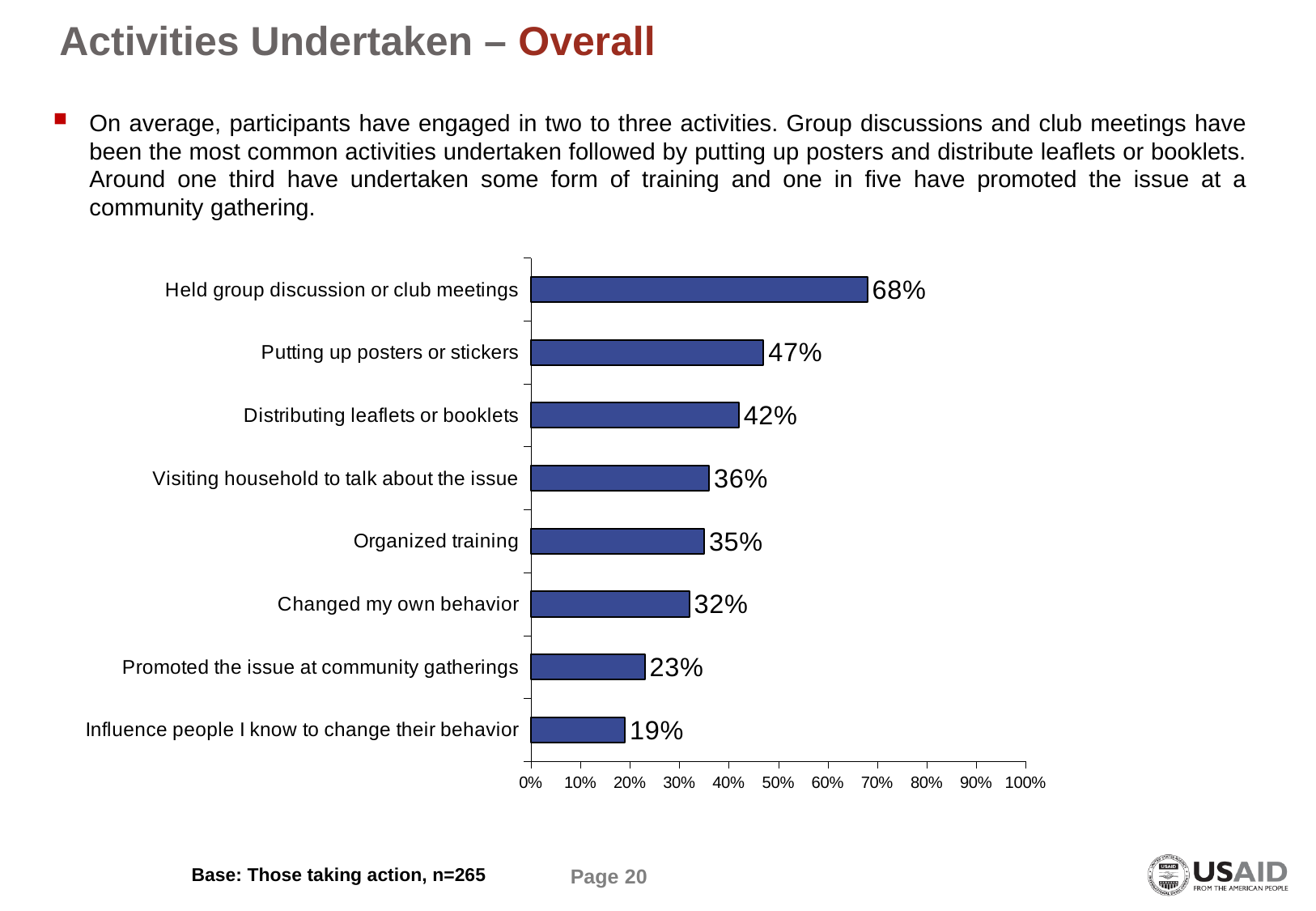
Which activity has the lowest percentage? Influence people I know to change their behavior How many activities are shown on the chart? 8 What is the difference between 'Putting up posters or stickers' and 'Distributing leaflets or booklets'? 5% What percentage of participants held group discussion or club meetings? 68% Which is larger: 'Changed my own behavior' or 'Promoted the issue at community gatherings'? Changed my own behavior What percentage of participants promoted the issue at community gatherings? 23% What is the difference between the highest and lowest values on the chart? 49% Is the value for 'Visiting household to talk about the issue' greater or less than 30%? greater What is the maximum value shown on the x axis? 100% What is the value for 'Organized training'? 35% Which activity has the highest percentage? Held group discussion or club meetings What kind of chart is shown on the slide? Bar chart